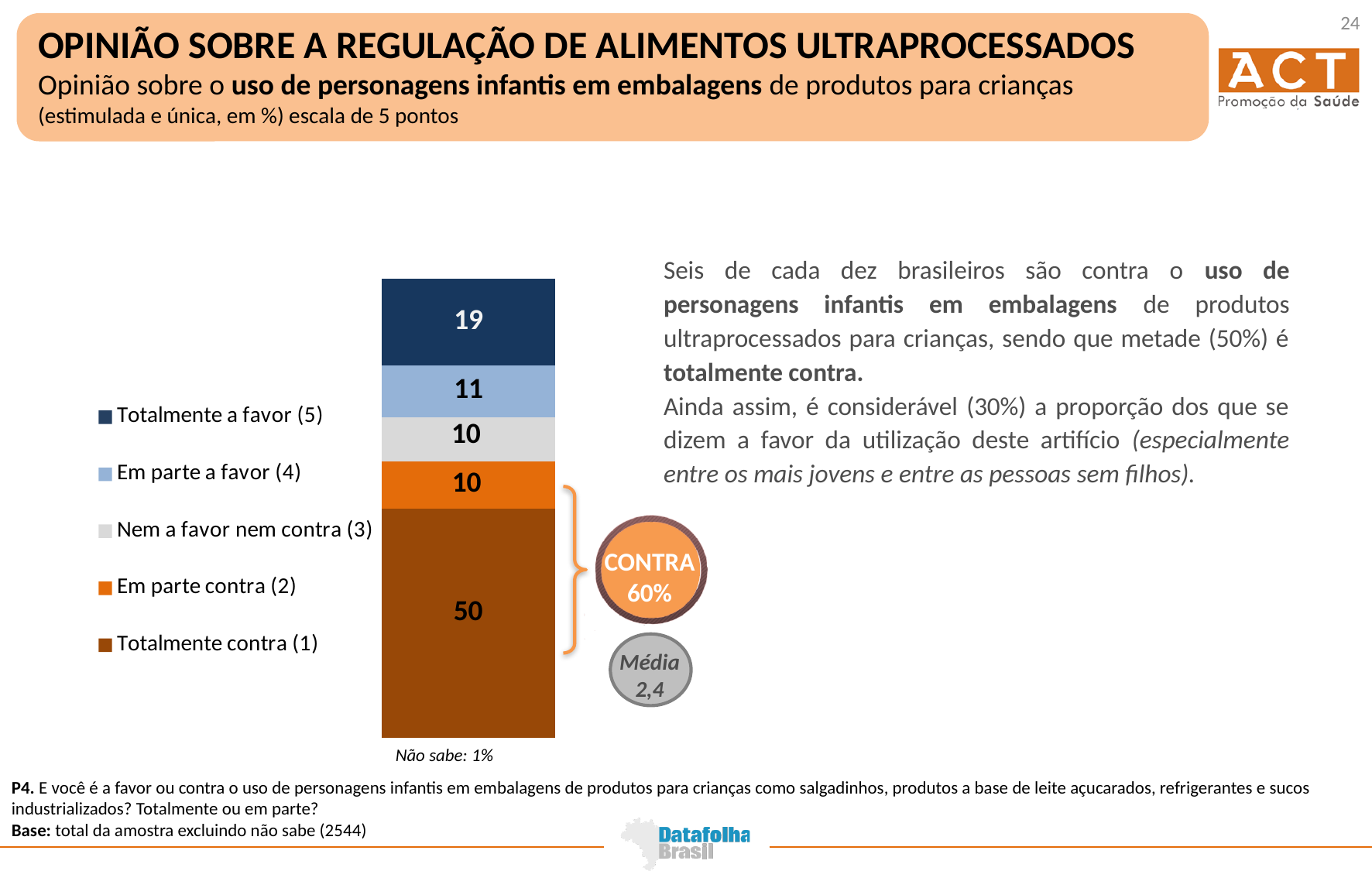
What is the difference between the values for "Totalmente contra (1)" and "Totalmente a favor (5)"? 31 What percentage is shown in the orange "CONTRA" circle next to the bar? 60% What kind of chart is shown on the slide? Stacked bar chart How many series does the legend list? 5 What is the difference between the values for "Totalmente a favor (5)" and "Em parte a favor (4)"? 8 What is the value for "Totalmente a favor (5)" in the stacked bar? 19 What is the total of all segments in the stacked bar? 100 Which legend category has the largest segment in the stacked bar? Totalmente contra (1) What is the value for "Nem a favor nem contra (3)" in the stacked bar? 10 What is the value for "Totalmente contra (1)" in the stacked bar? 50 Which is larger, the value for "Totalmente a favor (5)" or the value for "Em parte contra (2)"? Totalmente a favor (5) What is the value for "Em parte a favor (4)" in the stacked bar? 11